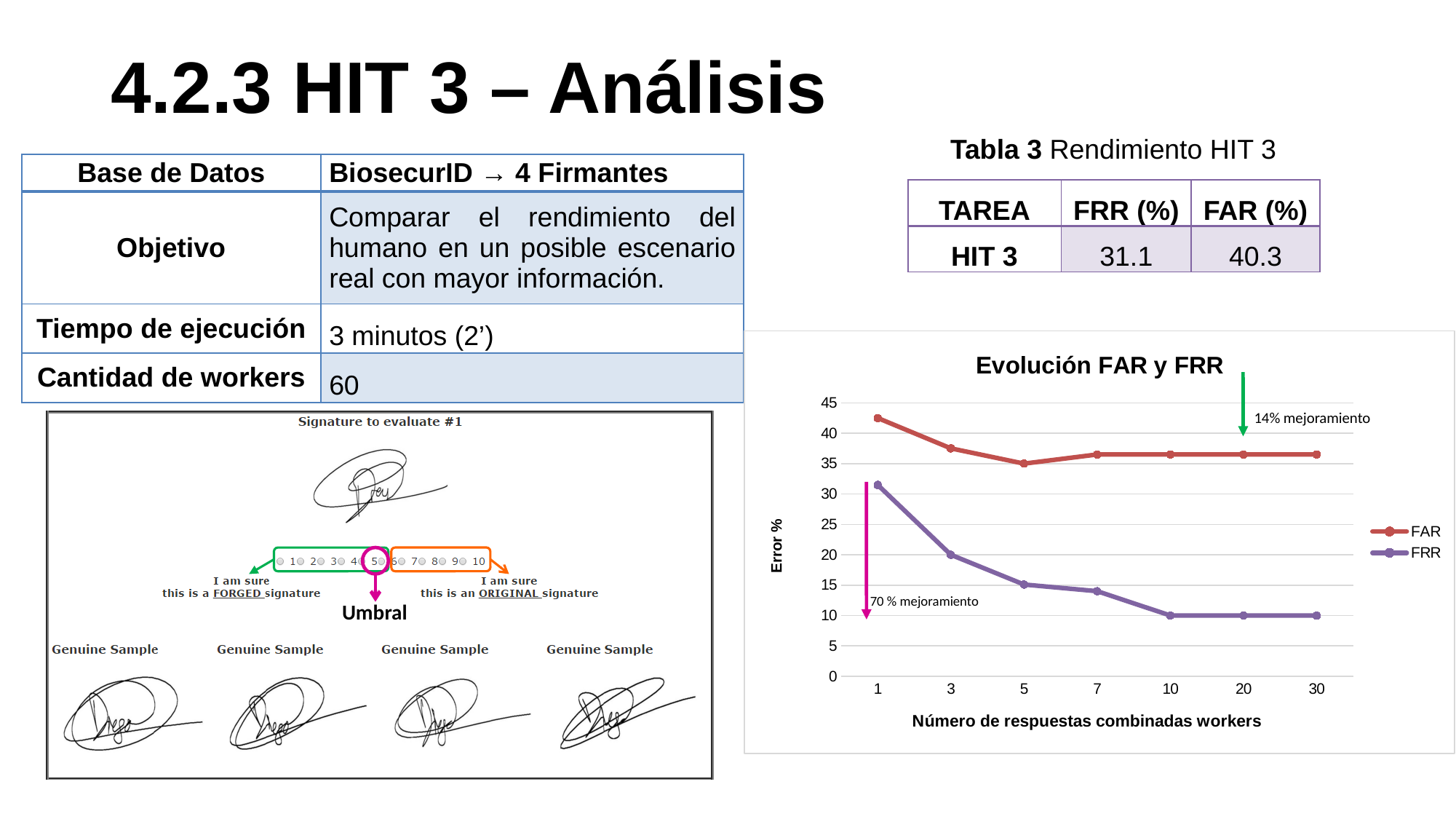
In the 'Evolución FAR y FRR' chart, is the FRR value at 1 combined response greater or less than 30? greater What is the y-axis label of the 'Evolución FAR y FRR' chart? Error % What kind of chart is 'Evolución FAR y FRR'? line chart In the 'Evolución FAR y FRR' chart, which series has the higher value at 10 combined responses, FAR or FRR? FAR In the 'Evolución FAR y FRR' chart, is the FAR value at 1 combined response greater or less than 40? greater In the 'Evolución FAR y FRR' chart, is the FRR value at 5 combined responses greater or less than 20? less What is the x-axis label of the 'Evolución FAR y FRR' chart? Número de respuestas combinadas workers How many points are plotted along the x axis for each series in the 'Evolución FAR y FRR' chart? 7 In the 'Evolución FAR y FRR' chart, does the FRR series rise or fall from 1 to 10 combined responses? fall How many series does the legend of the 'Evolución FAR y FRR' chart list? 2 In the 'Evolución FAR y FRR' chart, at which number of combined responses is the FRR value highest? 1